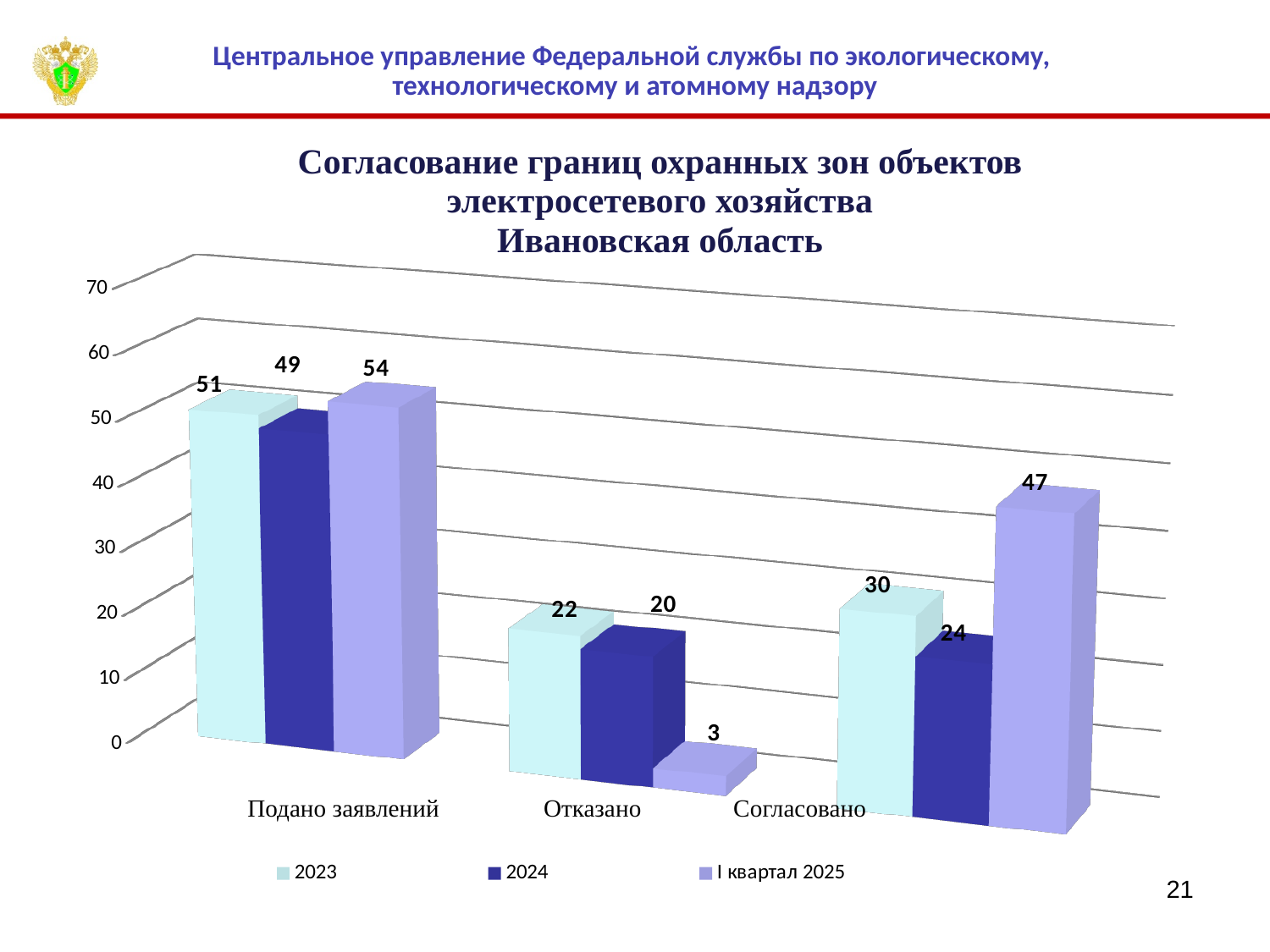
How many series does the legend list? 3 What is the difference between the 2023 and 2024 values in the 'Отказано' category? 2 Which series has the highest value in the 'Подано заявлений' category? I квартал 2025 How many categories are shown on the x axis? 3 Which region is named in the chart title? Ивановская область What is the value for 2023 in the 'Подано заявлений' category? 51 What kind of chart is shown on the slide? Bar chart What is the value for 'I квартал 2025' in the 'Отказано' category? 3 Which series has the lowest value in the 'Отказано' category? I квартал 2025 What is the value for 2024 in the 'Согласовано' category? 24 Which is larger: the 2023 value for 'Согласовано' or the 2024 value for 'Согласовано'? 2023 What is the difference between the 'I квартал 2025' and 2023 values in the 'Согласовано' category? 17